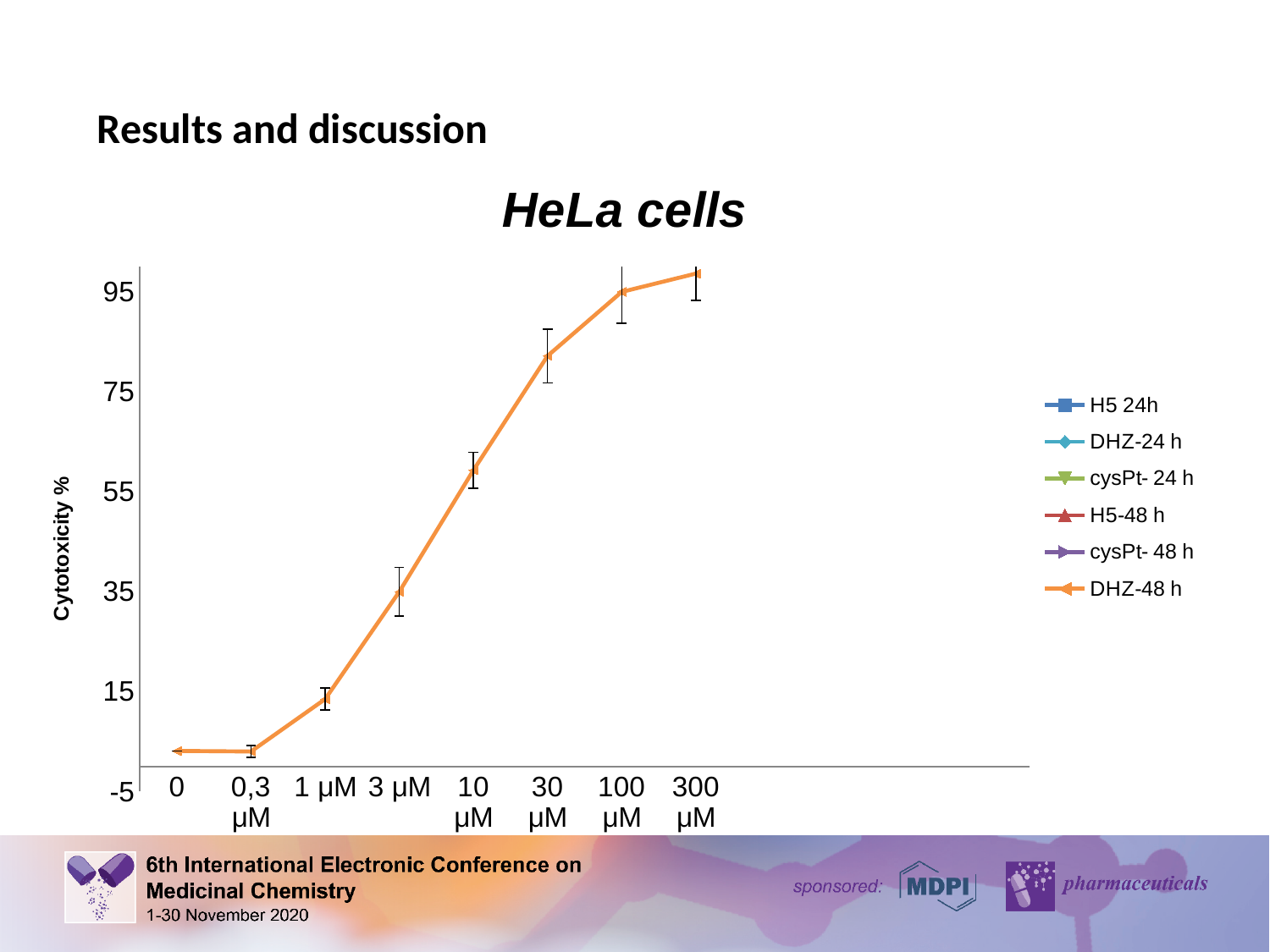
Is the cytotoxicity value at 1 µM greater or less than 35? less What is the label of the y axis? Cytotoxicity % What kind of chart is shown on the slide? line chart Is the cytotoxicity value at 10 µM greater or less than 55? greater How many series does the legend list? 6 What is the title of the chart? HeLa cells How many concentration points are plotted along the x axis? 8 Is the cytotoxicity value at 30 µM greater or less than 75? greater At which concentration is the plotted cytotoxicity highest? 300 µM Which is larger, the cytotoxicity value at 30 µM or at 10 µM? 30 µM Do the plotted cytotoxicity values rise or fall as the concentration increases along the x axis? rise